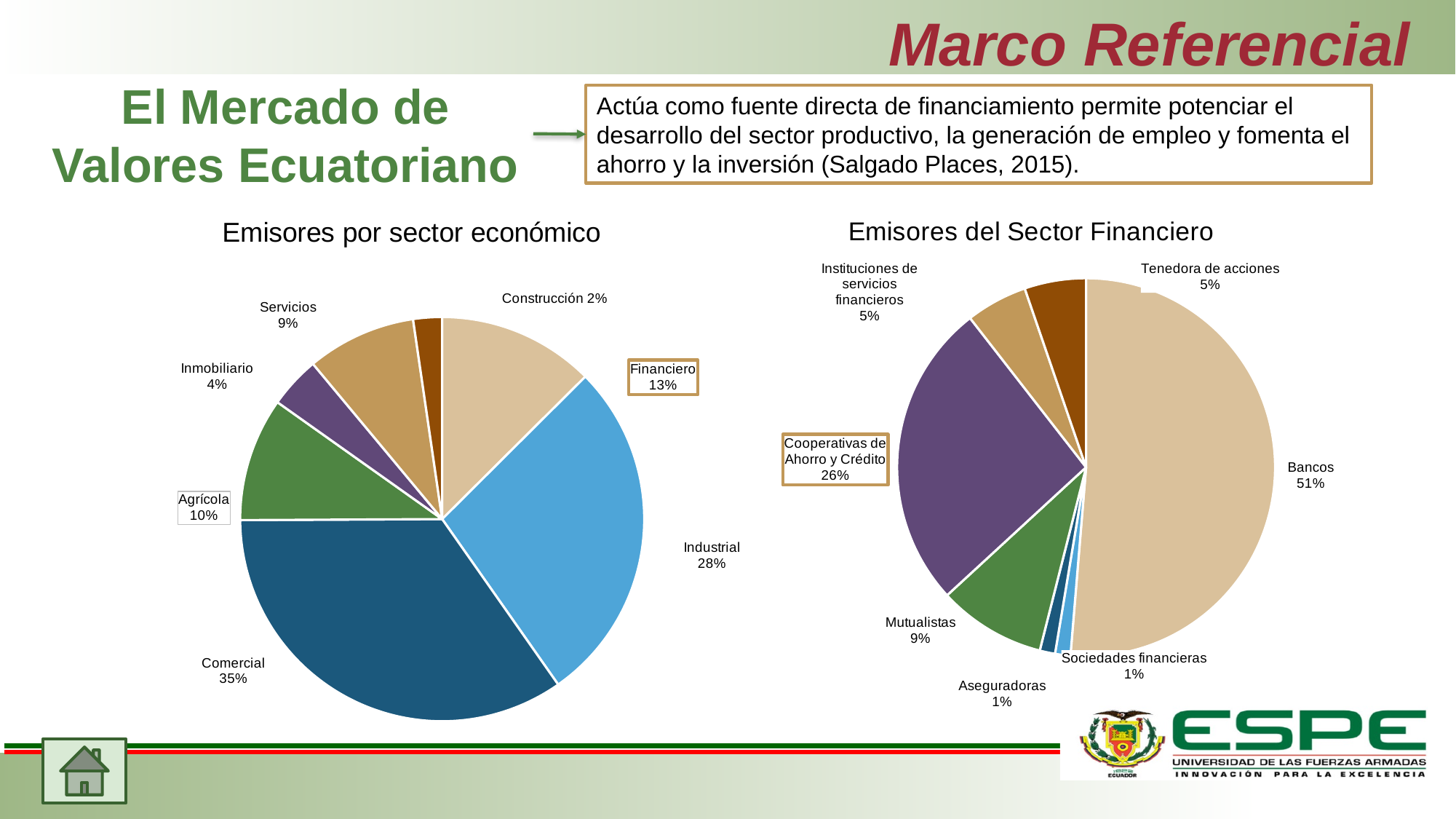
In the 'Emisores del Sector Financiero' chart, how many categories are shown? 7 In the 'Emisores por sector económico' chart, which sector has the largest share? Comercial In the 'Emisores por sector económico' chart, how many sectors are shown? 7 In the 'Emisores por sector económico' chart, what is the difference between the Industrial and Agrícola shares? 18% In the 'Emisores del Sector Financiero' chart, what share do Cooperativas de Ahorro y Crédito have? 26% What kind of chart is 'Emisores del Sector Financiero'? Pie chart In the 'Emisores por sector económico' chart, which sector has the smallest share? Construcción In the 'Emisores por sector económico' chart, what share does Comercial have? 35% In the 'Emisores del Sector Financiero' chart, which is larger: Mutualistas or Tenedora de acciones? Mutualistas In the 'Emisores del Sector Financiero' chart, which category has the largest share? Bancos In the 'Emisores del Sector Financiero' chart, what share do Bancos have? 51% In the 'Emisores por sector económico' chart, what share does Financiero have? 13%